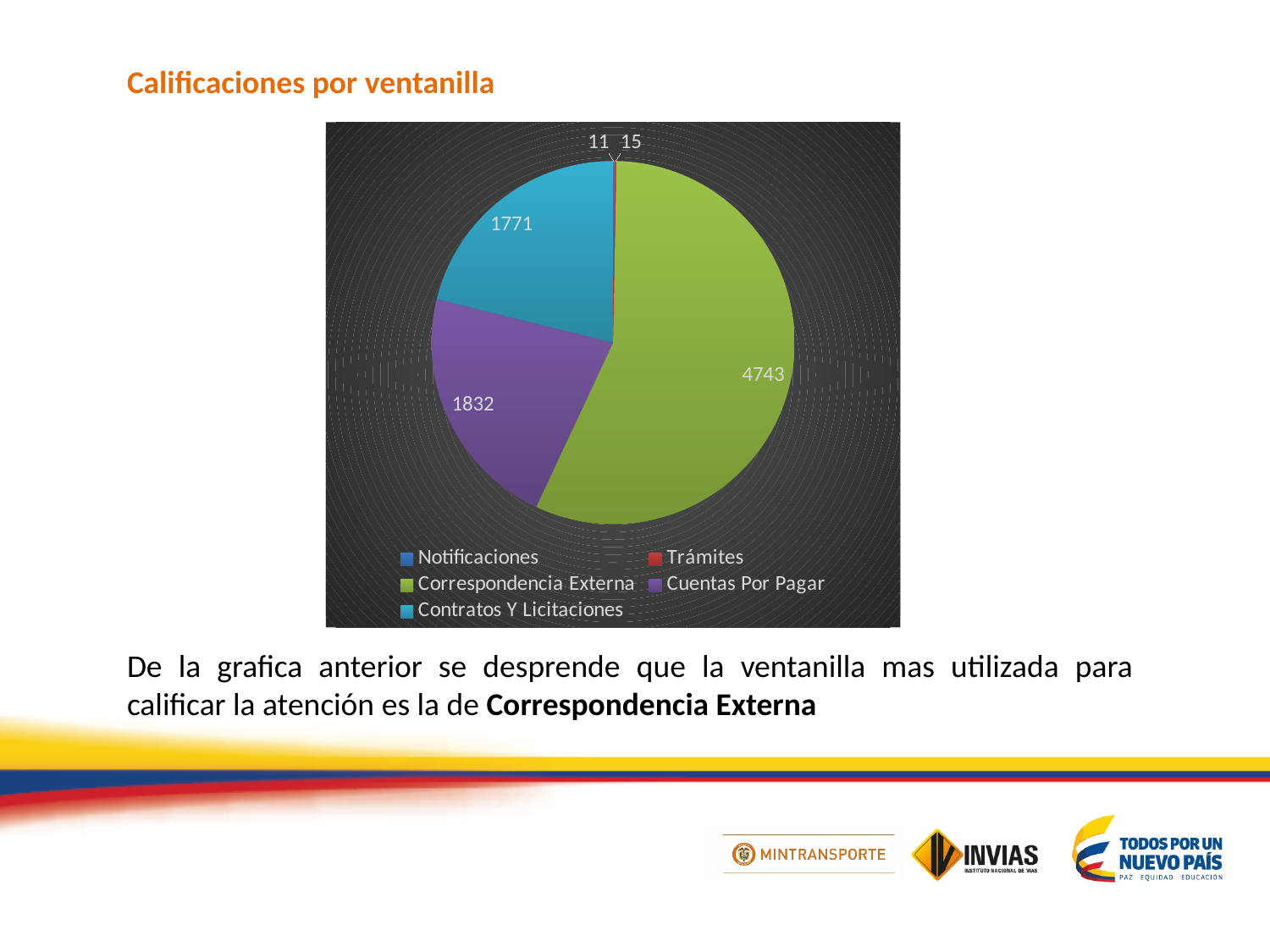
Which is larger, Cuentas Por Pagar or Contratos Y Licitaciones? Cuentas Por Pagar Which category has the largest slice of the pie? Correspondencia Externa What is the difference between the values for Cuentas Por Pagar and Contratos Y Licitaciones? 61 What is the smallest value shown on the pie chart? 11 What is the value for Contratos Y Licitaciones? 1771 What colour is the Correspondencia Externa slice? Green What is the value for Cuentas Por Pagar? 1832 What is the value for Correspondencia Externa? 4743 What is the difference between the values for Correspondencia Externa and Cuentas Por Pagar? 2911 What type of chart is shown on the slide? Pie chart What is the total of all the values shown on the pie chart? 8372 How many categories does the pie chart show? 5